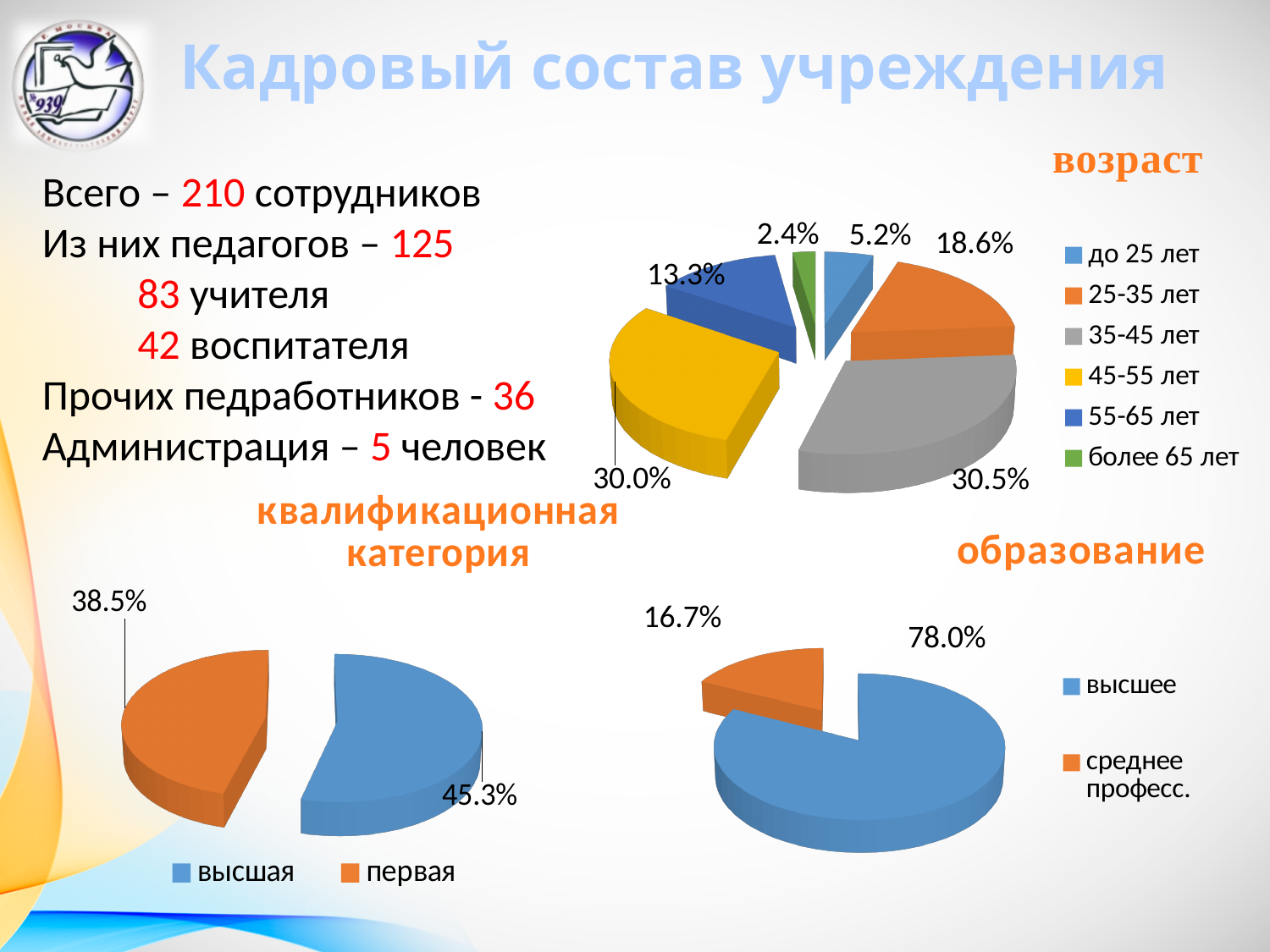
On the 'возраст' chart, what is the difference between the shares for '25-35 лет' and '55-65 лет'? 5.3% On the 'возраст' chart, what share is shown for 'до 25 лет'? 5.2% On the 'возраст' chart, what share is shown for '55-65 лет'? 13.3% On the 'возраст' chart, what share is shown for '35-45 лет'? 30.5% What kind of chart is the 'образование' chart? pie chart On the 'возраст' chart, which is larger: the share for '25-35 лет' or for 'до 25 лет'? 25-35 лет On the 'квалификационная категория' chart, what share is shown for 'первая'? 38.5% On the 'образование' chart, what share is shown for 'среднее професс.'? 16.7% On the 'возраст' chart, which age group has the smallest share? более 65 лет On the 'образование' chart, what share is shown for 'высшее'? 78.0% On the 'квалификационная категория' chart, which category has the larger share, 'высшая' or 'первая'? высшая On the 'возраст' chart, how many age groups does the legend list? 6